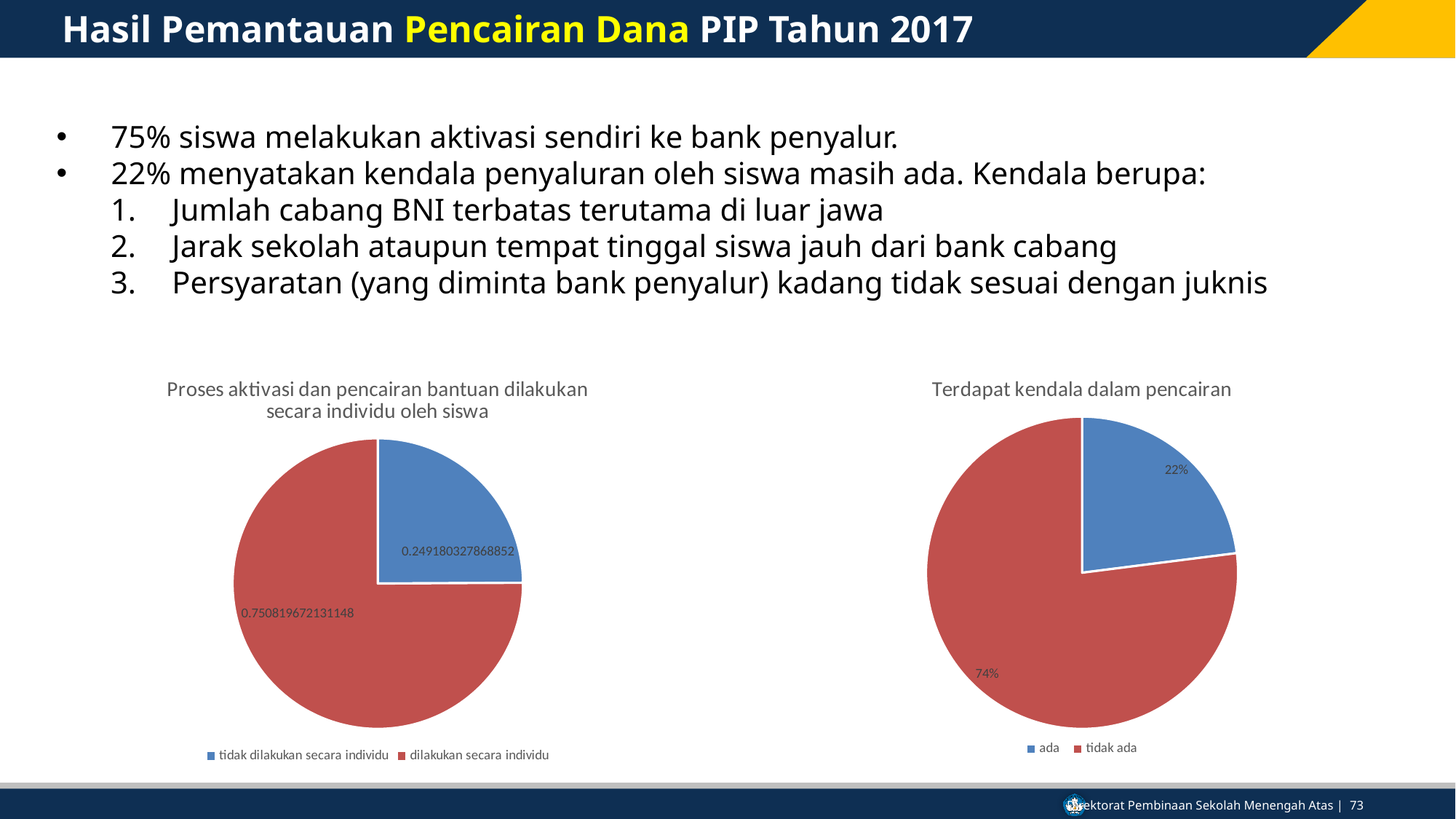
In the right chart, 'Terdapat kendala dalam pencairan', what percentage is shown for 'ada'? 22% In the right chart, 'Terdapat kendala dalam pencairan', which category has the smallest slice? ada In the right chart, 'Terdapat kendala dalam pencairan', what percentage is shown for 'tidak ada'? 74% In the right chart, 'Terdapat kendala dalam pencairan', what colour is the slice for 'ada'? blue In the right chart, 'Terdapat kendala dalam pencairan', which is larger: 'ada' or 'tidak ada'? tidak ada What type of chart is the left chart, 'Proses aktivasi dan pencairan bantuan dilakukan secara individu oleh siswa'? pie chart In the left chart, 'Proses aktivasi dan pencairan bantuan dilakukan secara individu oleh siswa', what value is shown for 'dilakukan secara individu'? 0.750819672131148 How many slices does the right chart, 'Terdapat kendala dalam pencairan', have? 2 In the left chart, 'Proses aktivasi dan pencairan bantuan dilakukan secara individu oleh siswa', what value is shown for 'tidak dilakukan secara individu'? 0.249180327868852 In the left chart, 'Proses aktivasi dan pencairan bantuan dilakukan secara individu oleh siswa', which category has the largest slice? dilakukan secara individu How many entries does the legend of the left chart, 'Proses aktivasi dan pencairan bantuan dilakukan secara individu oleh siswa', list? 2 In the right chart, 'Terdapat kendala dalam pencairan', what is the difference in percentage points between 'tidak ada' and 'ada'? 52